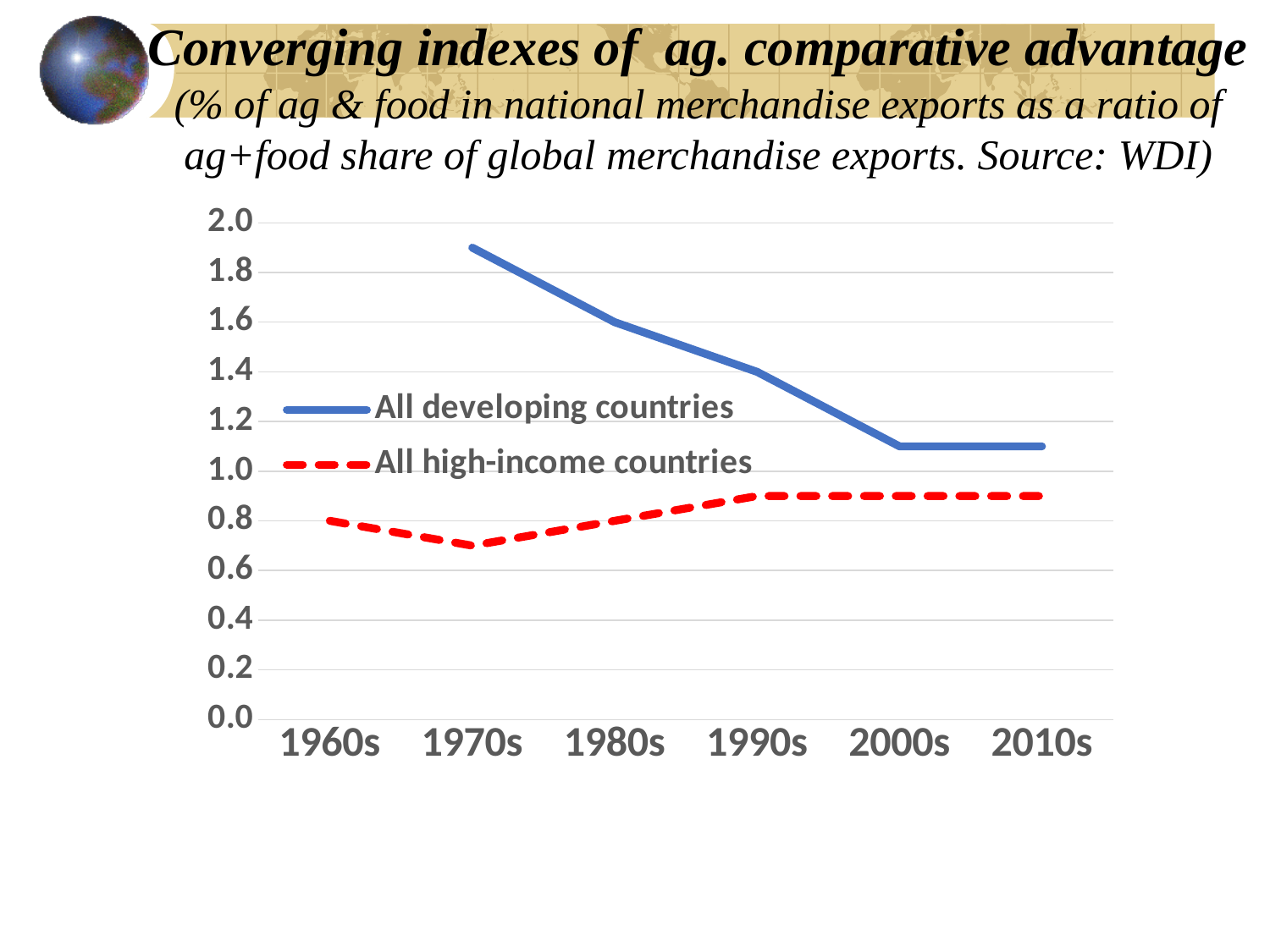
How many decades are shown on the x axis? 6 Is the value for All high-income countries in the 1970s greater or less than 0.8? less In which decade is the index for All developing countries highest? 1970s How many series does the legend list? 2 Is the value for All developing countries in the 1970s greater or less than 1.8? greater In the 1990s, which series has the larger value, All developing countries or All high-income countries? All developing countries Which series is drawn as a red dashed line? All high-income countries Is the value for All developing countries in the 2010s greater or less than 1.0? greater What kind of chart is shown on the slide? line chart In which decade is the index for All high-income countries lowest? 1970s Does the index for All developing countries rise or fall from the 1970s to the 2010s? fall